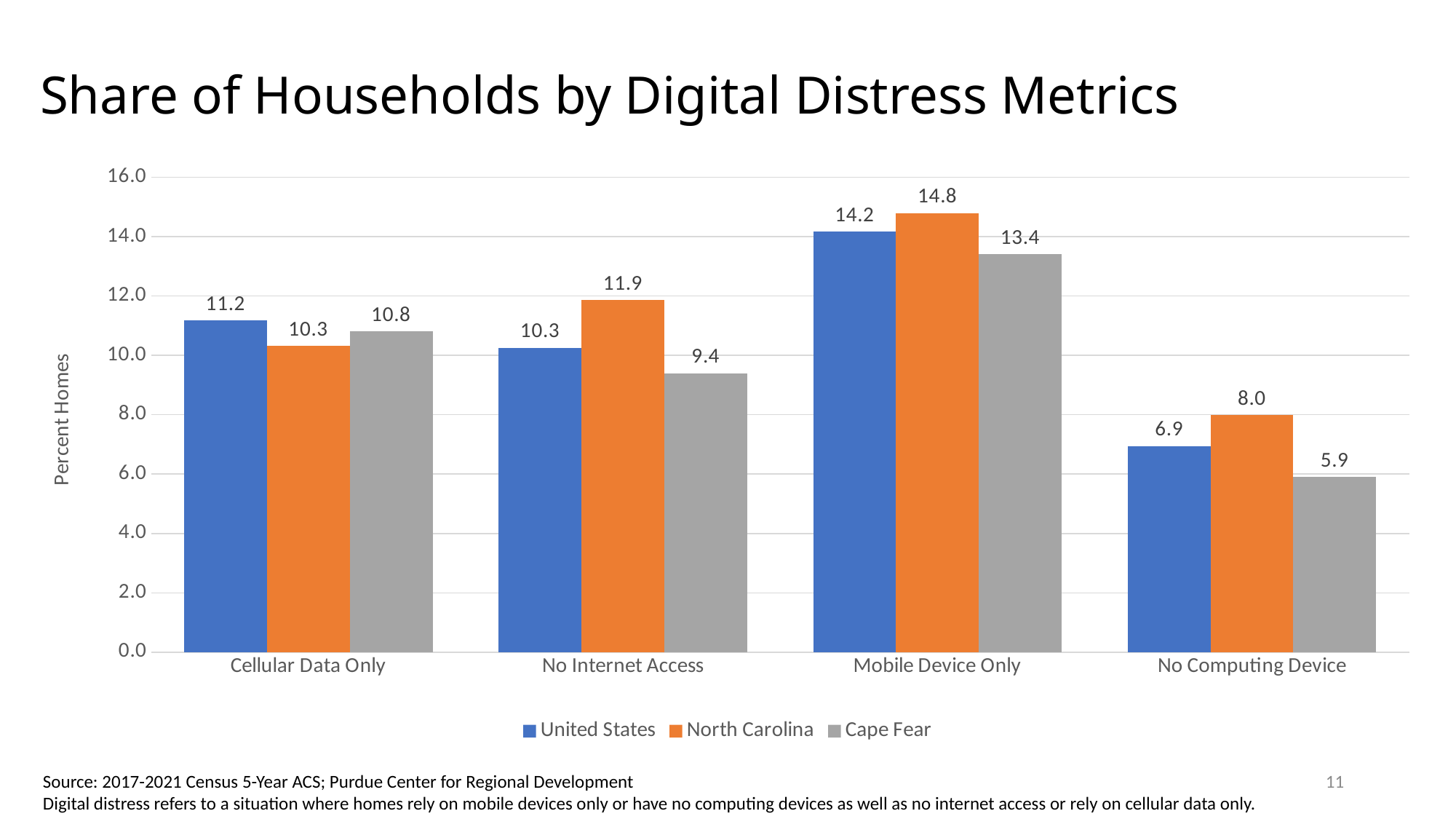
How many series does the legend list? 3 How many categories are shown on the x axis? 4 What is the value for Cape Fear in the No Internet Access category? 9.4 What is the label of the y axis? Percent Homes Which is larger in the Cellular Data Only category: the United States value or the Cape Fear value? United States Is the value for Cape Fear in the Mobile Device Only category greater or less than 12.0? greater What kind of chart is shown on the slide? Bar chart What is the value for North Carolina in the Mobile Device Only category? 14.8 Which category has the lowest value for North Carolina? No Computing Device What is the value for the United States in the No Computing Device category? 6.9 Which category has the highest value for Cape Fear? Mobile Device Only What is the difference between the North Carolina and Cape Fear values in the No Internet Access category? 2.5